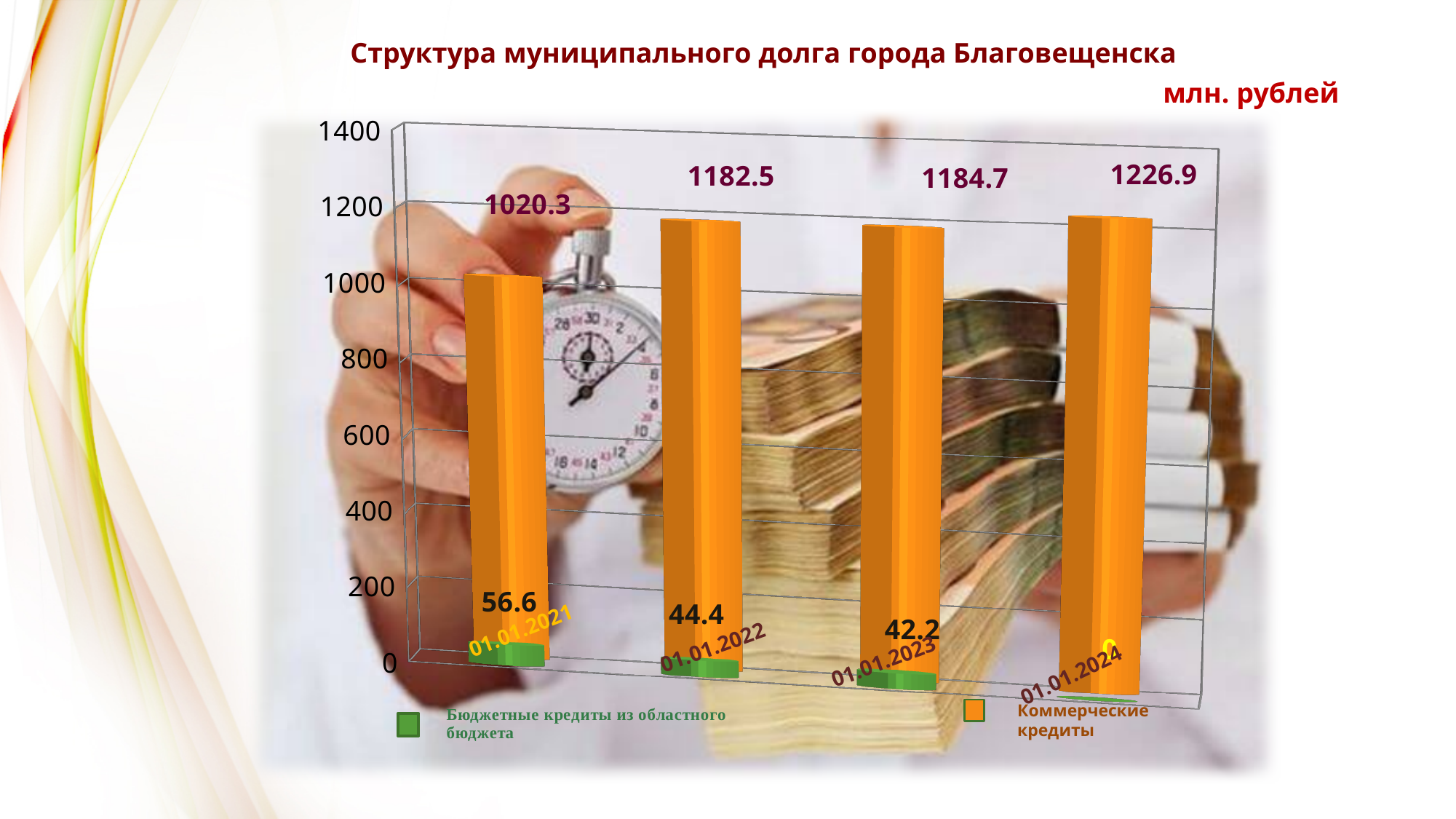
On which date is the value of Коммерческие кредиты the highest? 01.01.2024 On which date is the value of Коммерческие кредиты the lowest? 01.01.2021 How many dates are shown on the x axis of the chart? 4 How many series does the legend list? 2 What is the value of Коммерческие кредиты on 01.01.2024? 1226.9 What kind of chart is shown on the slide? bar chart What is the difference between the Коммерческие кредиты values on 01.01.2022 and 01.01.2021? 162.2 What is the value of Коммерческие кредиты on 01.01.2021? 1020.3 What is the value of Бюджетные кредиты из областного бюджета on 01.01.2023? 42.2 Which is larger: Бюджетные кредиты из областного бюджета on 01.01.2021 or on 01.01.2022? 01.01.2021 What is the value of Бюджетные кредиты из областного бюджета on 01.01.2021? 56.6 Do the values of Коммерческие кредиты rise or fall from 01.01.2021 to 01.01.2024? rise